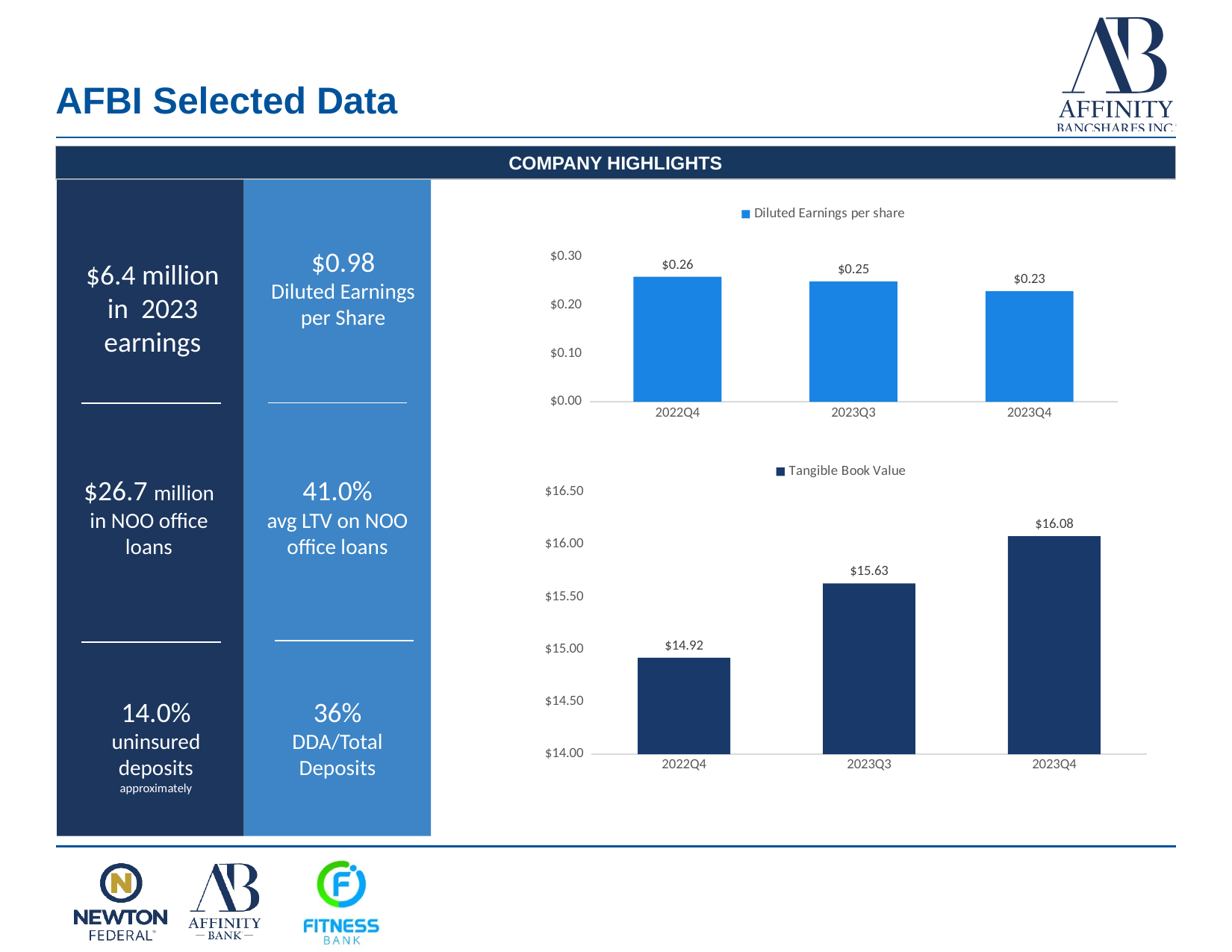
How many quarters are shown in the Tangible Book Value chart? 3 In the Tangible Book Value chart, which quarter has the highest value? 2023Q4 In the Diluted Earnings per share chart, which quarter has the lowest value? 2023Q4 In the Diluted Earnings per share chart, what is the value for 2023Q4? $0.23 In the Diluted Earnings per share chart, do the values rise or fall from 2022Q4 to 2023Q4? fall In the Tangible Book Value chart, is the value for 2023Q4 greater or less than $16.00? greater In the Tangible Book Value chart, what is the difference between 2023Q4 and 2022Q4? $1.16 In the Diluted Earnings per share chart, what is the value for 2022Q4? $0.26 In the Tangible Book Value chart, what is the value for 2022Q4? $14.92 What kind of chart is the Diluted Earnings per share chart? bar chart In the Tangible Book Value chart, what is the value for 2023Q3? $15.63 In the Diluted Earnings per share chart, what is the difference between 2022Q4 and 2023Q4? $0.03